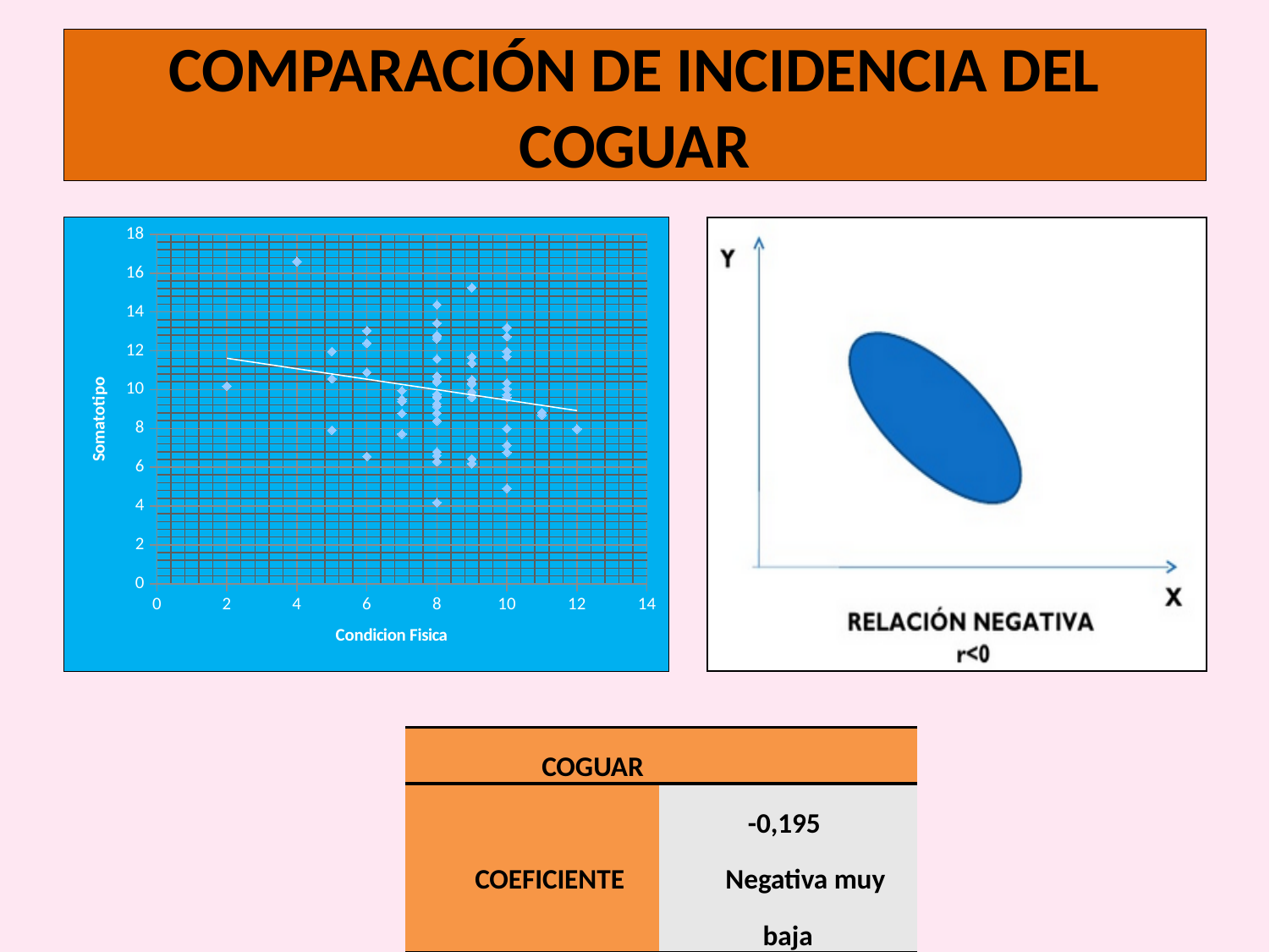
In the scatter chart on the left, does the trend line rise or fall as Condicion Fisica increases? fall In the scatter chart on the left, is the Somatotipo value of the highest plotted point greater or less than 16? greater What is the title of the x axis of the scatter chart on the left? Condicion Fisica In the scatter chart on the left, is the Somatotipo value of the lowest plotted point greater or less than 6? less What kind of chart is shown on the left of the slide? scatter chart In the scatter chart on the left, is the Somatotipo value of the point with the largest Condicion Fisica (at 12) greater or less than 10? less What is the title of the y axis of the scatter chart on the left? Somatotipo